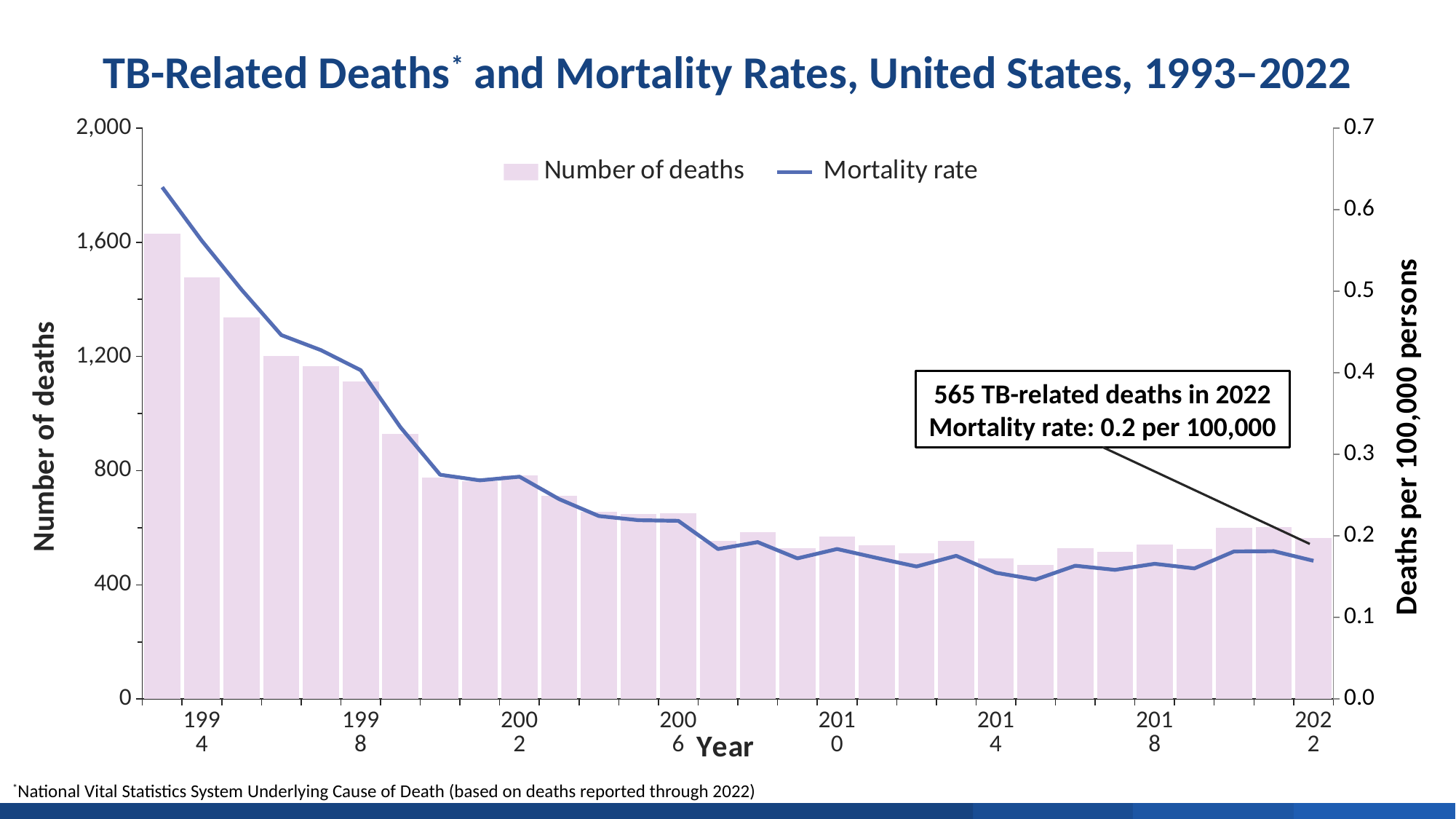
Which year has a higher number of deaths, 1994 or 2022? 1994 How many series does the legend list? 2 Is the number of deaths in 2022 greater or less than 800? less What was the TB mortality rate in 2022? 0.2 per 100,000 What kind of chart is shown on the slide? A combined bar chart and line chart Is the mortality rate in 2014 greater or less than 0.2? less What is the title of the right-hand vertical axis? Deaths per 100,000 persons How many TB-related deaths were there in 2022? 565 Which year has a higher mortality rate, 1998 or 2010? 1998 Does the number of TB-related deaths generally rise or fall from 1993 to 2022? Fall Which year has the highest number of TB-related deaths? 1993 Is the number of deaths in 1994 greater or less than 1,200? greater